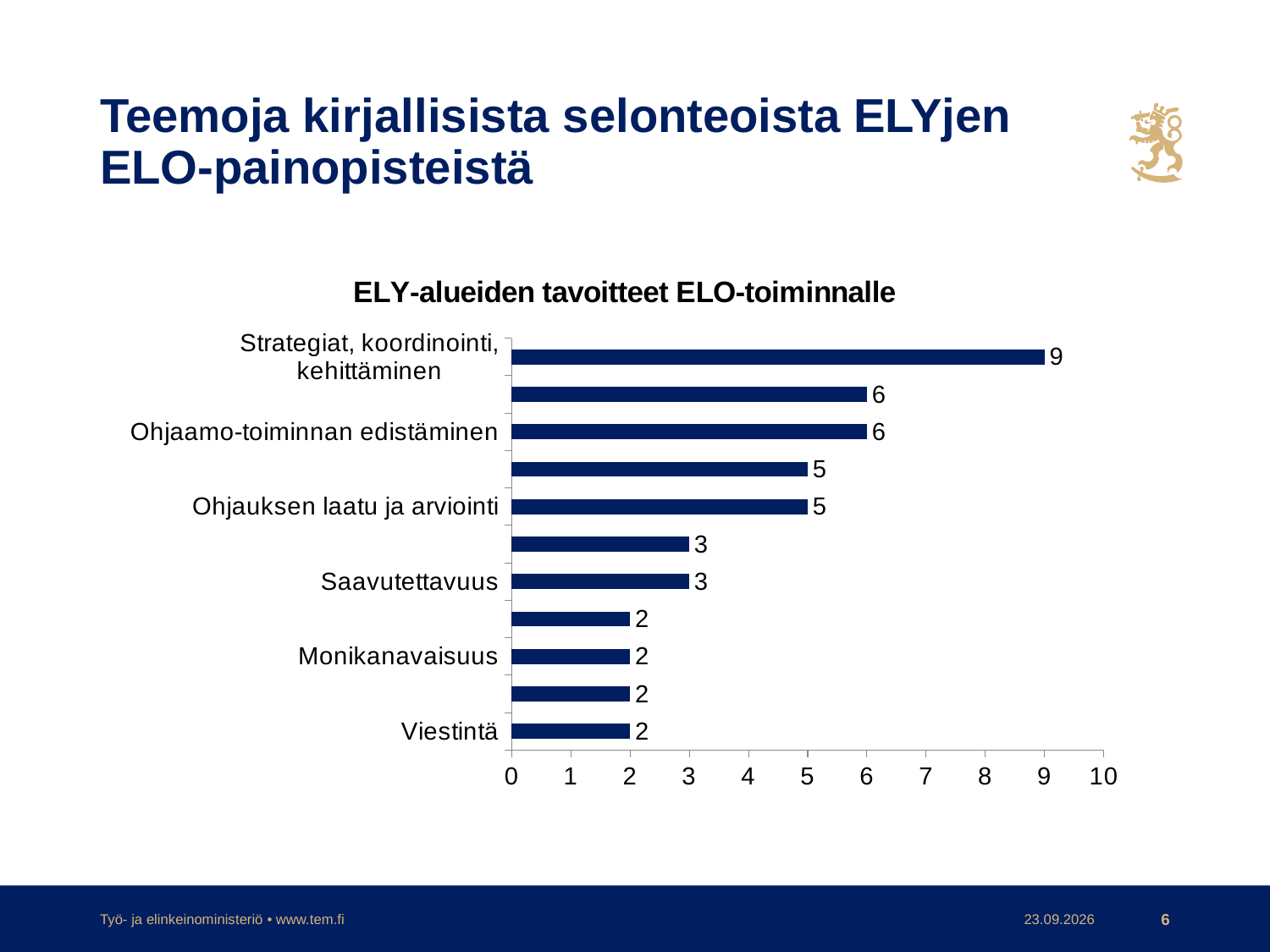
Which is larger, the value for Ohjauksen laatu ja arviointi or the value for Saavutettavuus? Ohjauksen laatu ja arviointi What kind of chart is shown on the slide? bar chart What is the value for Ohjauksen laatu ja arviointi? 5 Which category has the highest value? Strategiat, koordinointi, kehittäminen What is the title of the chart? ELY-alueiden tavoitteet ELO-toiminnalle How many bars are plotted in the chart? 11 Is the value for Strategiat, koordinointi, kehittäminen greater or less than 8? greater What is the value for Viestintä? 2 What is the difference between the values for Strategiat, koordinointi, kehittäminen and Ohjaamo-toiminnan edistäminen? 3 What is the value for Strategiat, koordinointi, kehittäminen? 9 What is the value for Saavutettavuus? 3 What is the value for Ohjaamo-toiminnan edistäminen? 6